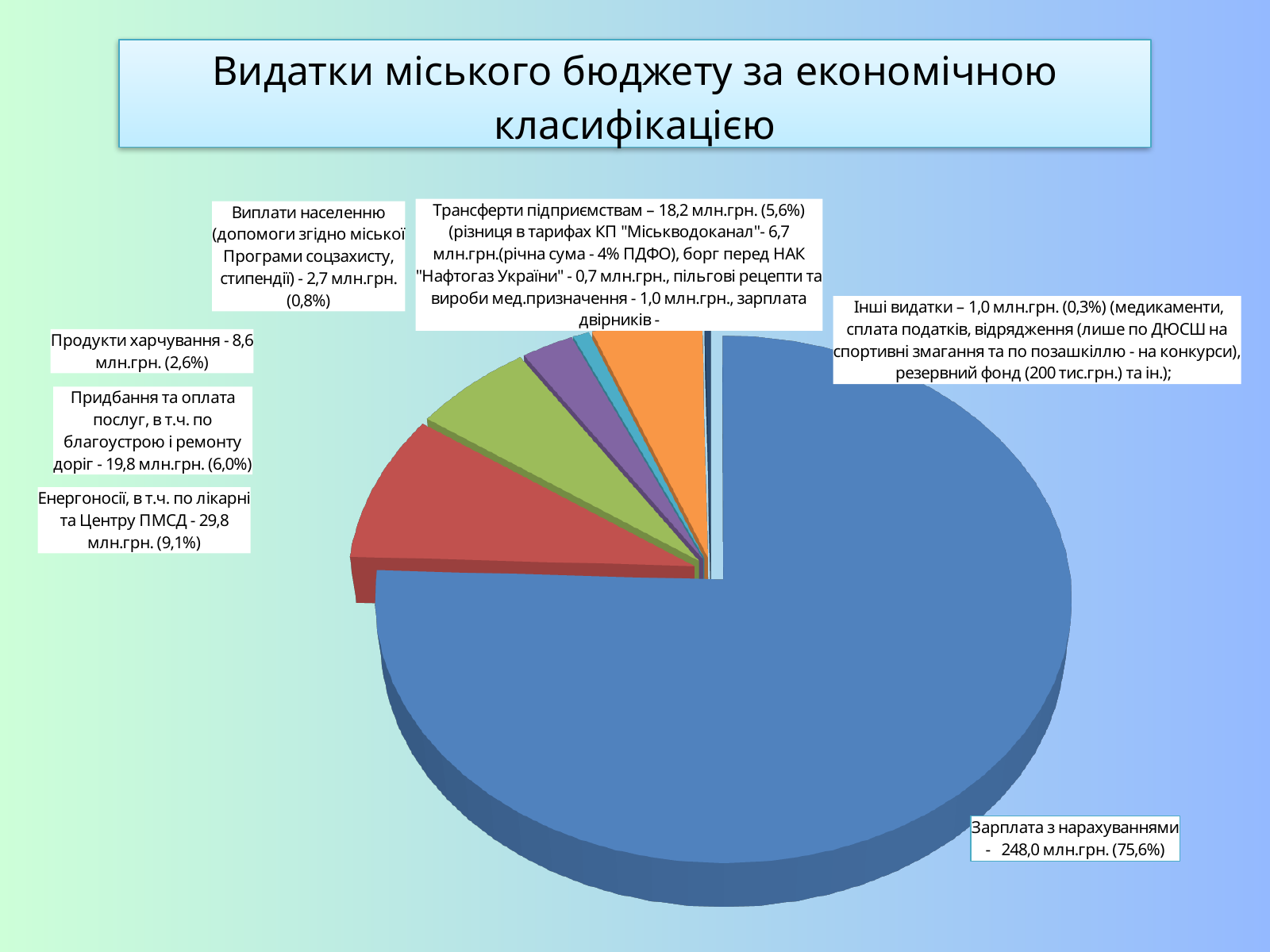
Which category has the largest share of the pie? Зарплата з нарахуваннями What is the value for Енергоносії, в т.ч. по лікарні та Центру ПМСД? 29,8 млн.грн. What share of the pie does Зарплата з нарахуваннями take? 75,6% What is the value for Трансферти підприємствам? 18,2 млн.грн. What is the difference in млн.грн. between Енергоносії and Продукти харчування? 21,2 млн.грн. Which category has the smallest share of the pie? Інші видатки What share of the pie does Придбання та оплата послуг, в т.ч. по благоустрою і ремонту доріг take? 6,0% What is the title of the chart on the slide? Видатки міського бюджету за економічною класифікацією What is the value for Зарплата з нарахуваннями? 248,0 млн.грн. What is the value for Продукти харчування? 8,6 млн.грн. Which is larger, Придбання та оплата послуг or Трансферти підприємствам? Придбання та оплата послуг What kind of chart is shown on the slide? pie chart